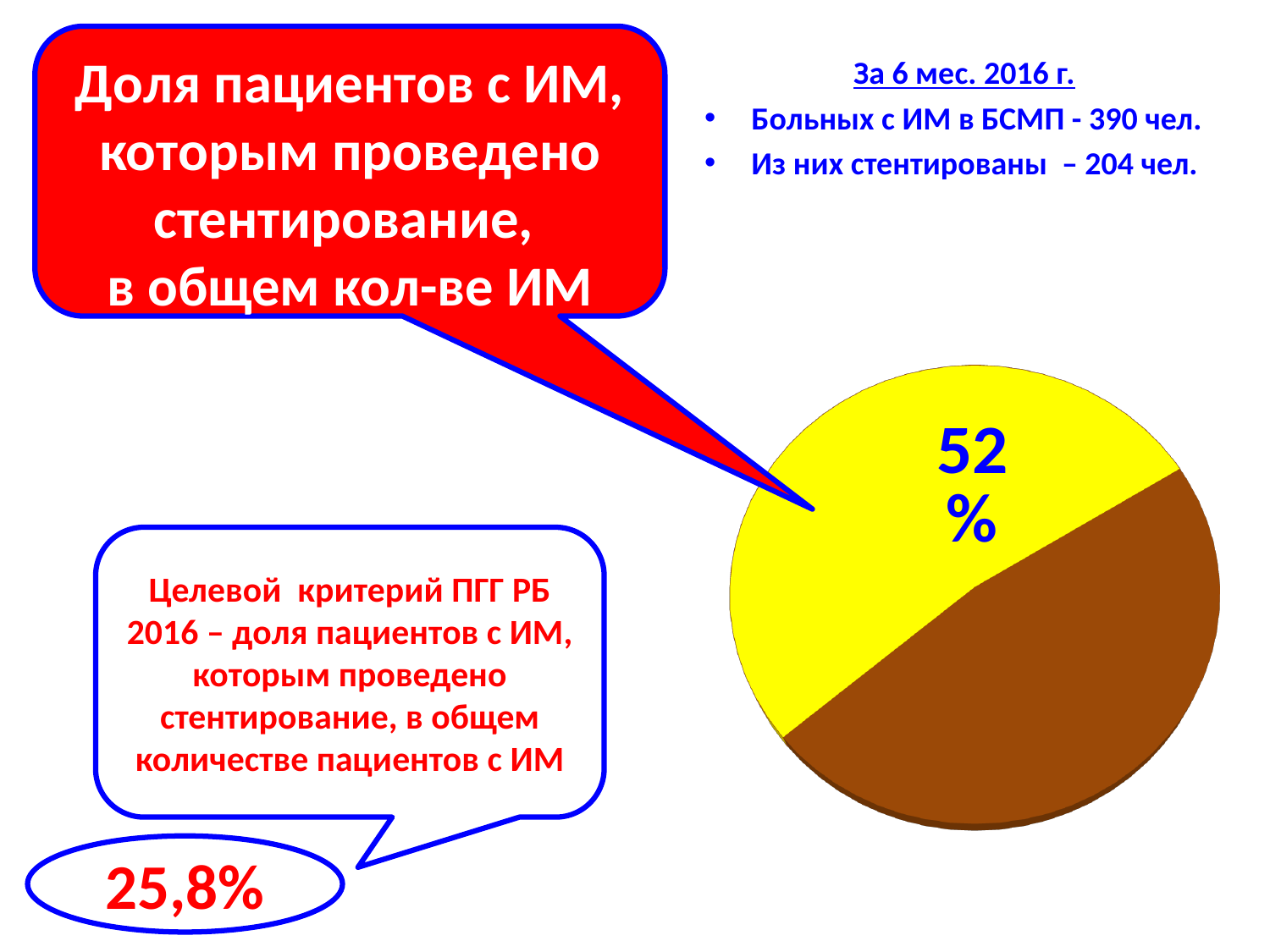
Which slice of the pie chart is larger, the yellow one or the brown one? yellow How many slices does the pie chart have? 2 Does the pie chart show a legend? no What colour is the slice of the pie chart labelled 52%? yellow What colour is the unlabelled slice of the pie chart? brown What kind of chart is shown on the slide? pie chart What percentage is printed on the yellow slice of the pie chart? 52%